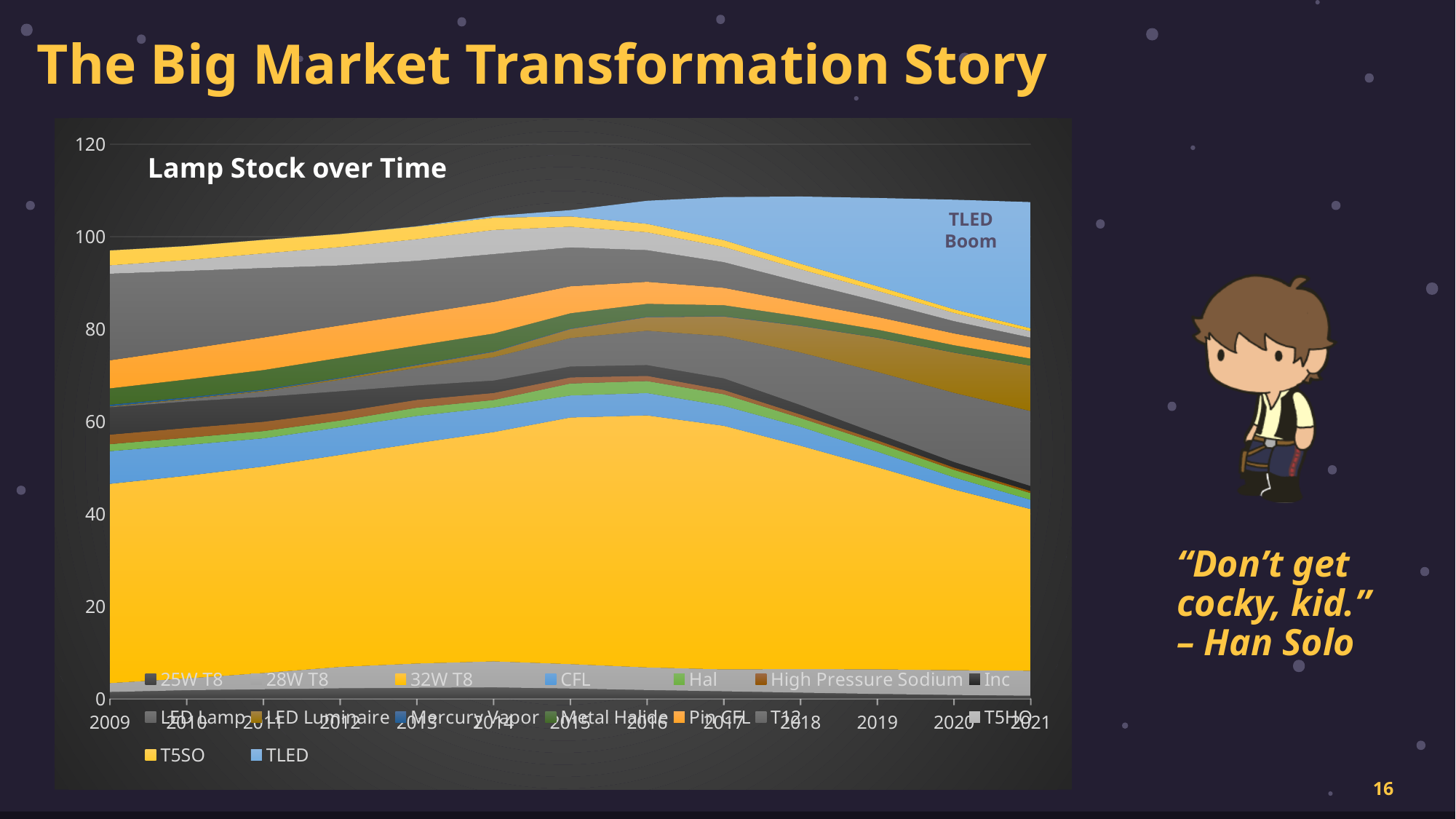
Is the total stacked lamp stock in 2009 greater or less than 100? less Does the total stacked lamp stock rise or fall from 2009 to 2016? rise What is the title of the chart? Lamp Stock over Time Does the TLED area grow or shrink from 2016 to 2021? grow What is the last year shown on the x axis? 2021 Which series is shown in light blue at the top of the stack in the later years? TLED What annotation text is placed on the light blue area at the right of the chart? TLED Boom How many years are shown along the x axis of the chart? 13 Is the total stacked lamp stock in 2021 greater or less than 100? greater What is the first year shown on the x axis? 2009 How many series does the chart's legend list? 16 What kind of chart is shown on the slide? Stacked area chart